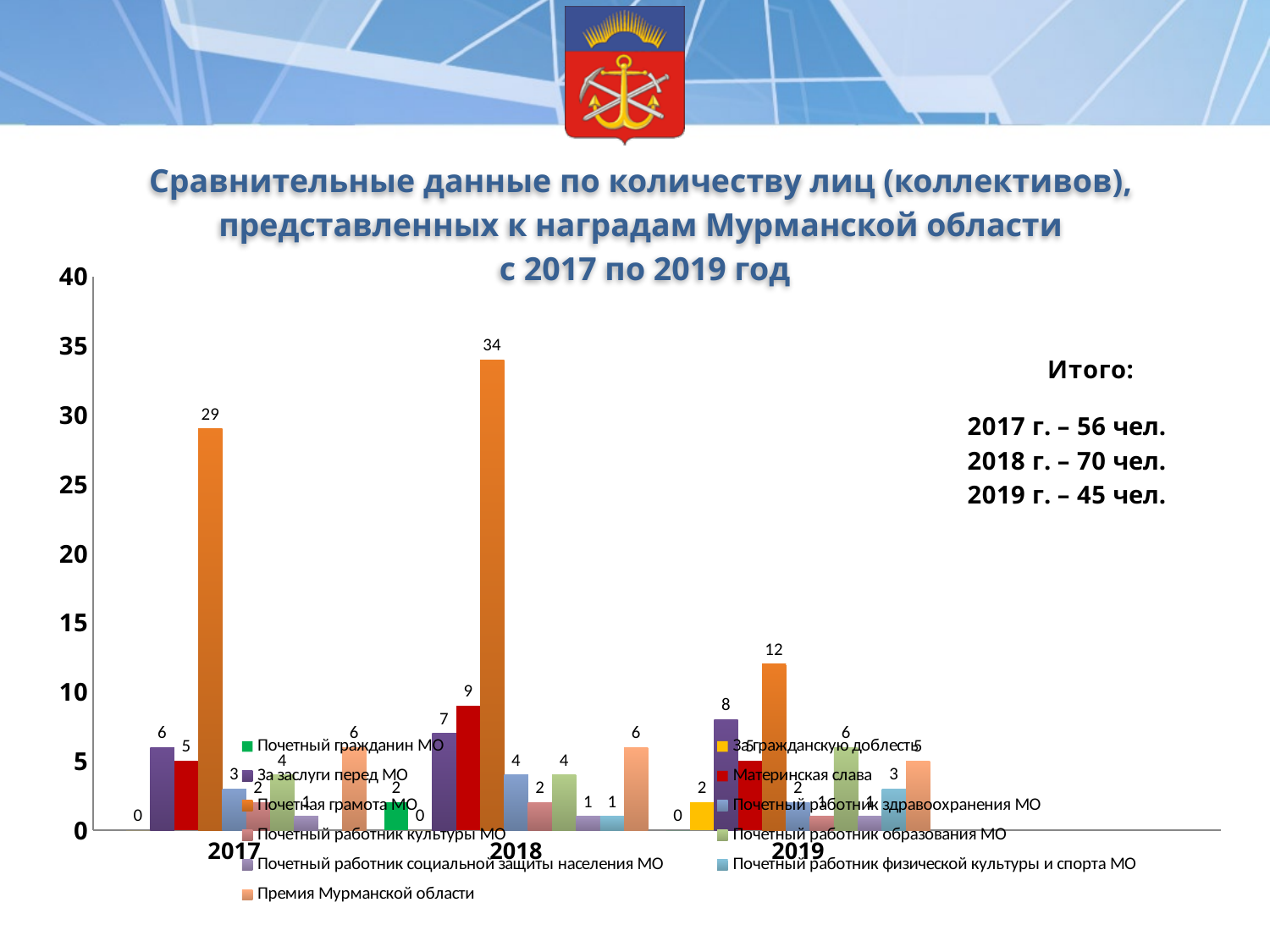
What is the value for Почетная грамота МО in 2017? 29 Is the value for Почетная грамота МО in 2018 greater or less than 30? greater How many year categories are shown on the x axis of the chart? 3 How many series does the chart legend list? 11 What kind of chart is shown on the slide? Bar chart Does the value for За заслуги перед МО rise or fall from 2017 to 2019? Rise What is the value for Почетная грамота МО in 2019? 12 What is the value for Почетная грамота МО in 2018? 34 Which is larger: the Материнская слава value in 2018 or in 2017? 2018 Which award has the highest value in the 2018 group? Почетная грамота МО According to the text on the slide, what is the total number of people for 2018? 70 чел. What is the difference between the Почетная грамота МО values for 2018 and 2017? 5